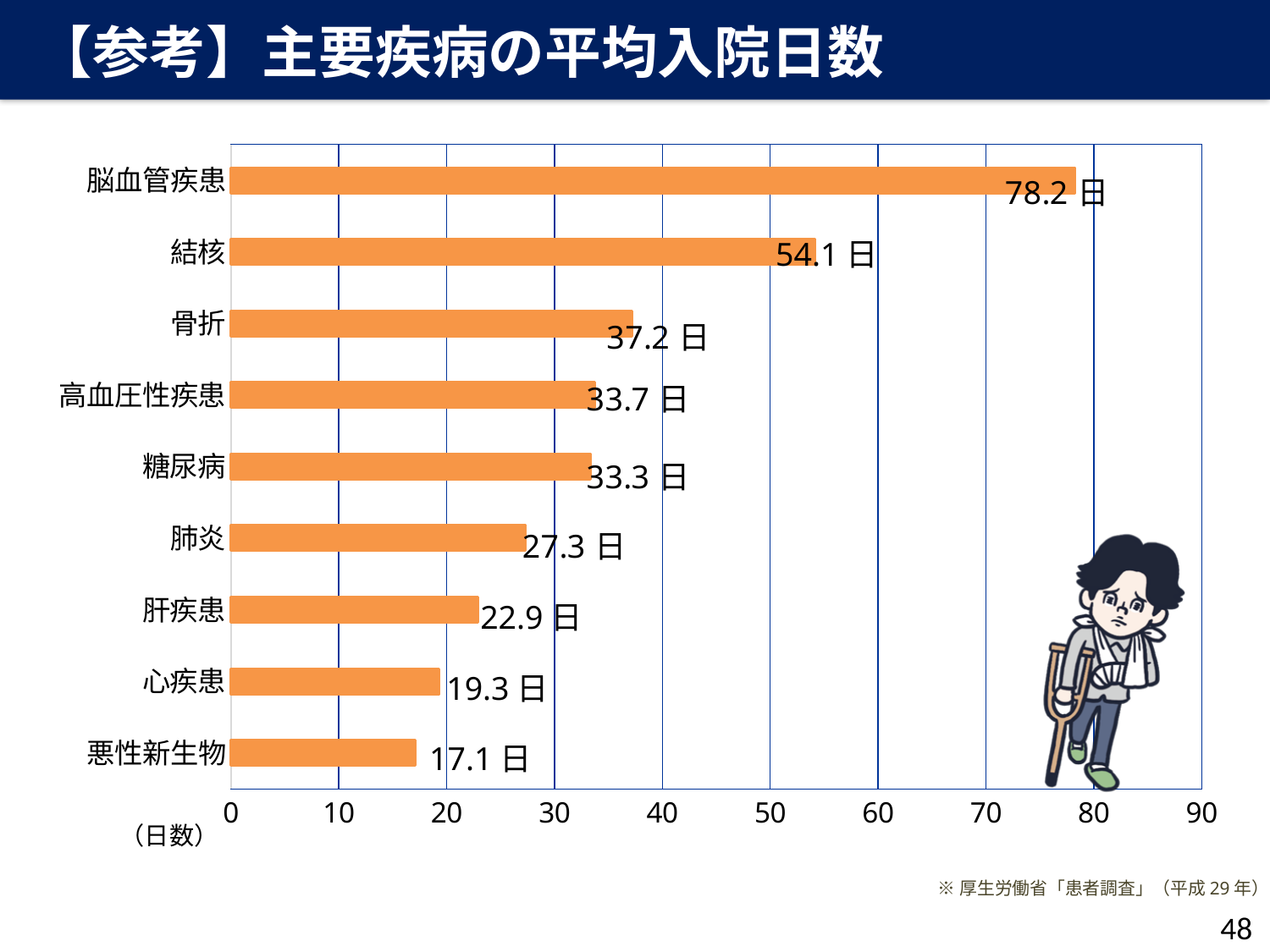
How many diseases are shown in the chart? 9 What is the average hospital stay for 脳血管疾患? 78.2 日 Which disease has the longest average hospital stay? 脳血管疾患 What kind of chart is shown on the slide? bar chart What is the average hospital stay for 悪性新生物? 17.1 日 What is the difference in average hospital stay between 骨折 and 肺炎? 9.9 日 Which has a longer average hospital stay, 肝疾患 or 心疾患? 肝疾患 What is the difference in average hospital stay between 脳血管疾患 and 結核? 24.1 日 What is the title of the slide? 【参考】主要疾病の平均入院日数 What is the average hospital stay for 結核? 54.1 日 Which disease has the shortest average hospital stay? 悪性新生物 Is the average hospital stay for 結核 greater or less than 50? greater